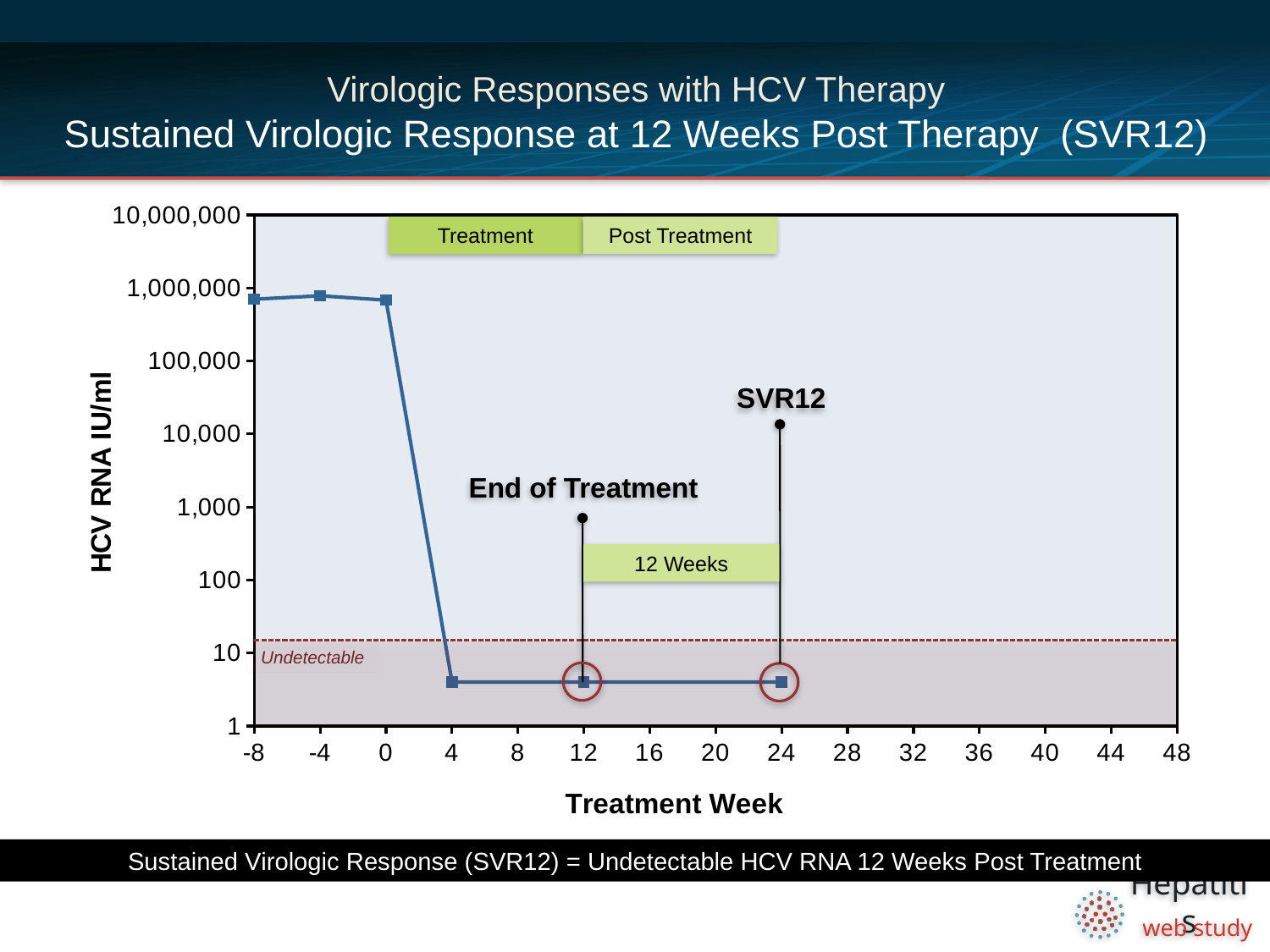
Which is larger, the HCV RNA value at week 0 or at week 4? week 0 Is the HCV RNA value at treatment week 4 greater or less than 10? less At which treatment week is the point labelled SVR12 located? 24 What kind of chart is shown on the slide? line chart How many data points are plotted on the line? 6 Is the HCV RNA value at treatment week -8 greater or less than 100,000? greater Do the HCV RNA values rise or fall between treatment week 0 and treatment week 4? fall What is the title of the x axis? Treatment Week What is the title of the y axis? HCV RNA IU/ml Is the HCV RNA value at treatment week 0 greater or less than 100,000? greater